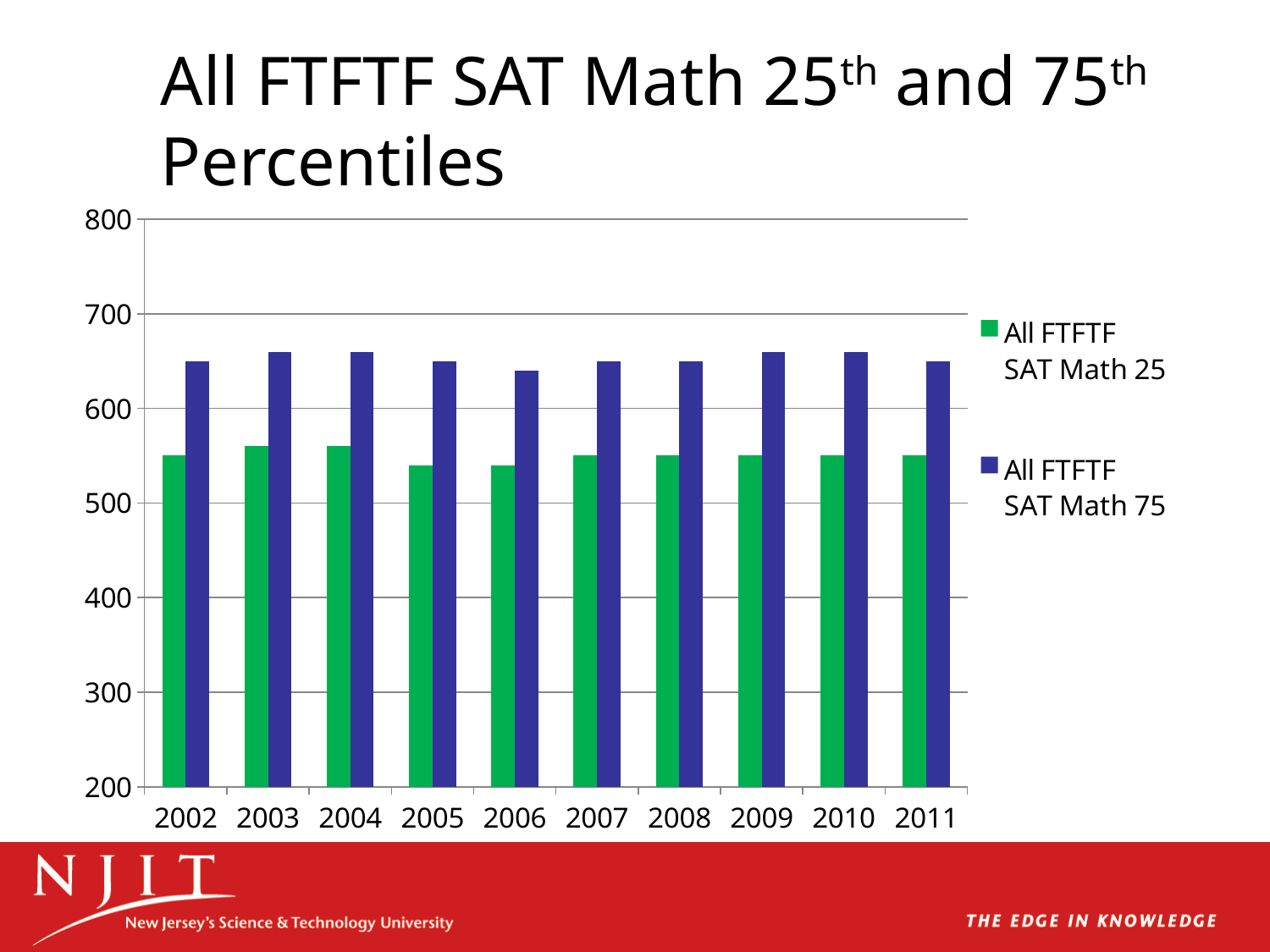
Is the value for All FTFTF SAT Math 25 in 2005 greater or less than 600? less Is the value for All FTFTF SAT Math 25 in 2011 greater or less than 400? greater How many series does the legend list? 2 What kind of chart is shown on the slide? bar chart In 2008, which is larger: All FTFTF SAT Math 25 or All FTFTF SAT Math 75? All FTFTF SAT Math 75 Which series is shown in green? All FTFTF SAT Math 25 How many years are shown on the x axis? 10 Is the value for All FTFTF SAT Math 75 in 2006 greater or less than 600? greater What is the first year shown on the x axis? 2002 What is the title of the chart? All FTFTF SAT Math 25th and 75th Percentiles